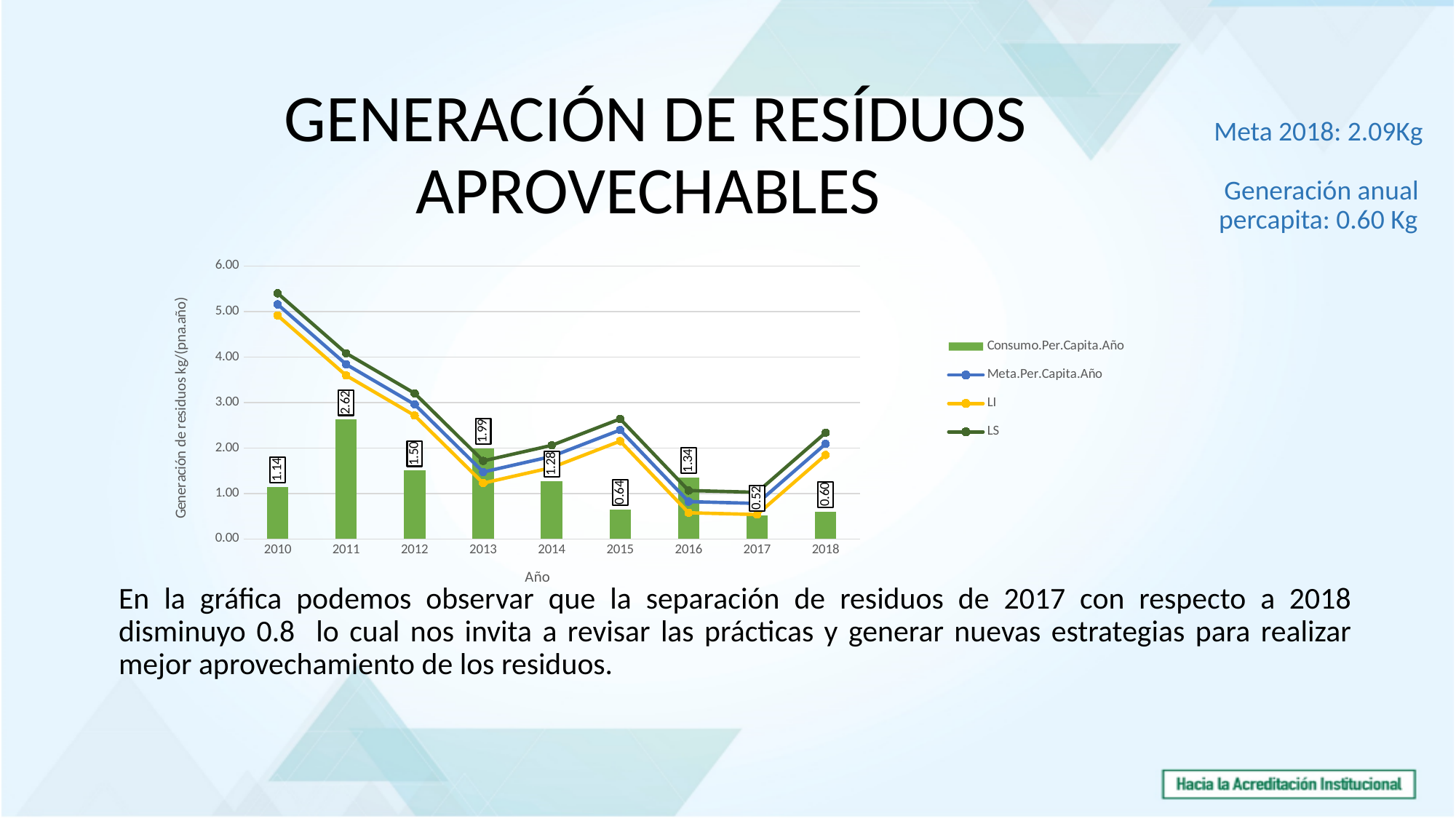
Which year has the lowest Consumo.Per.Capita.Año bar? 2017 Is the LS value for 2010 greater or less than 5.00? greater What is the difference between the Consumo.Per.Capita.Año values for 2011 and 2012? 1.12 What is the Consumo.Per.Capita.Año value for 2011? 2.62 Which year has the highest Consumo.Per.Capita.Año bar? 2011 Is the LI value for 2017 greater or less than 1.00? less What is the Consumo.Per.Capita.Año value for 2014? 1.28 What is the Consumo.Per.Capita.Año value for 2018? 0.60 How many series does the legend list? 4 How many years are shown on the x axis? 9 What kind of chart is shown on the slide? Combined bar and line chart Which is larger, the Consumo.Per.Capita.Año value for 2013 or for 2016? 2013